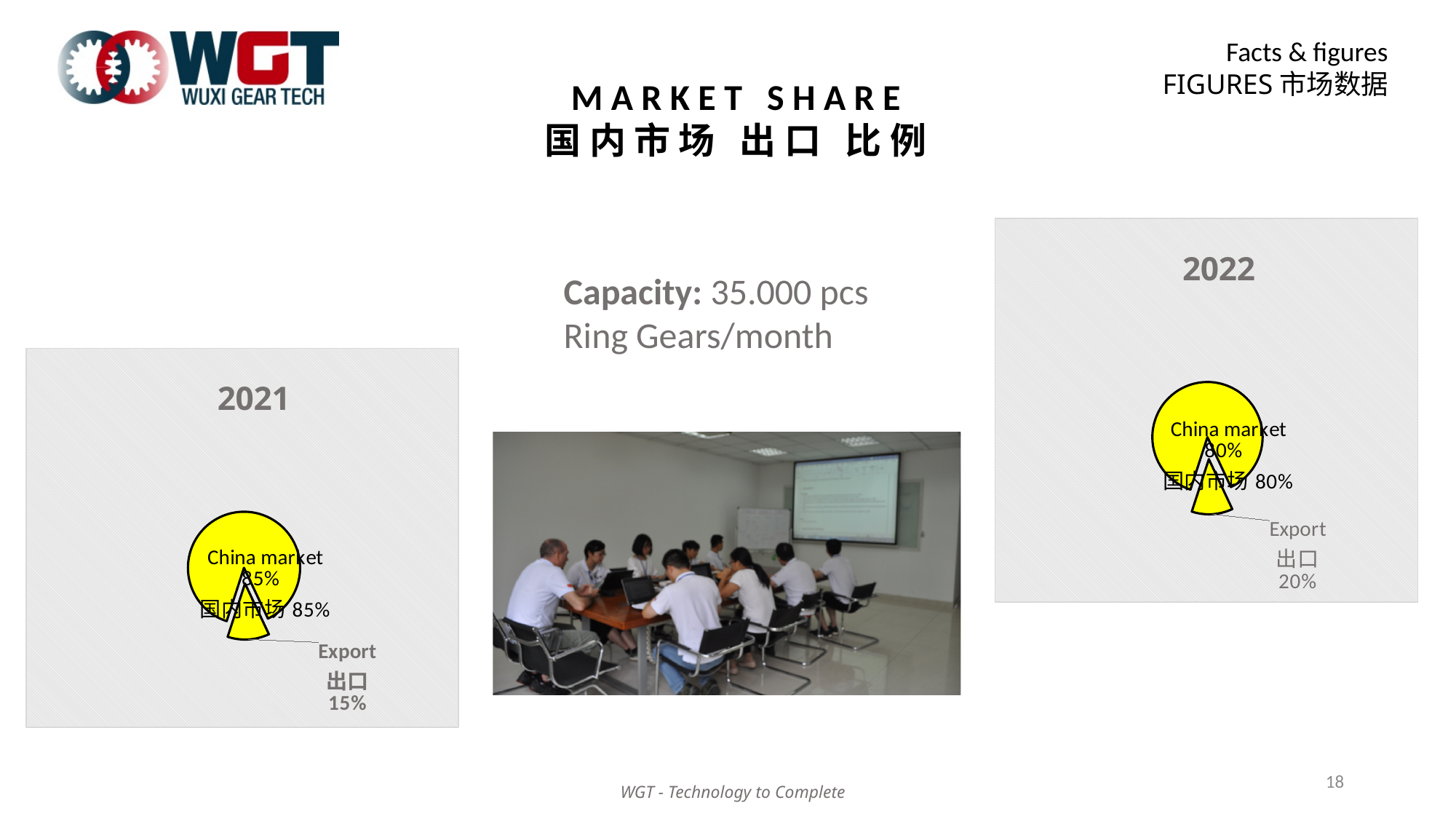
In the 2021 chart, what is the difference between the China market share and the Export share? 70% What colour is the China market slice in the 2021 chart? Yellow How many slices does the 2022 chart have? 2 In the 2021 chart, which slice is the largest? China market Which chart shows a larger Export share, the 2021 chart or the 2022 chart? 2022 In the 2021 chart, what share does the China market slice have? 85% In the 2022 chart, what share does the Export slice have? 20% In the 2022 chart, what is the difference between the China market share and the Export share? 60% In the 2022 chart, what share does the China market slice have? 80% In the 2022 chart, which slice is the smallest? Export What kind of chart is the 2021 chart? Pie chart In the 2021 chart, what share does the Export slice have? 15%